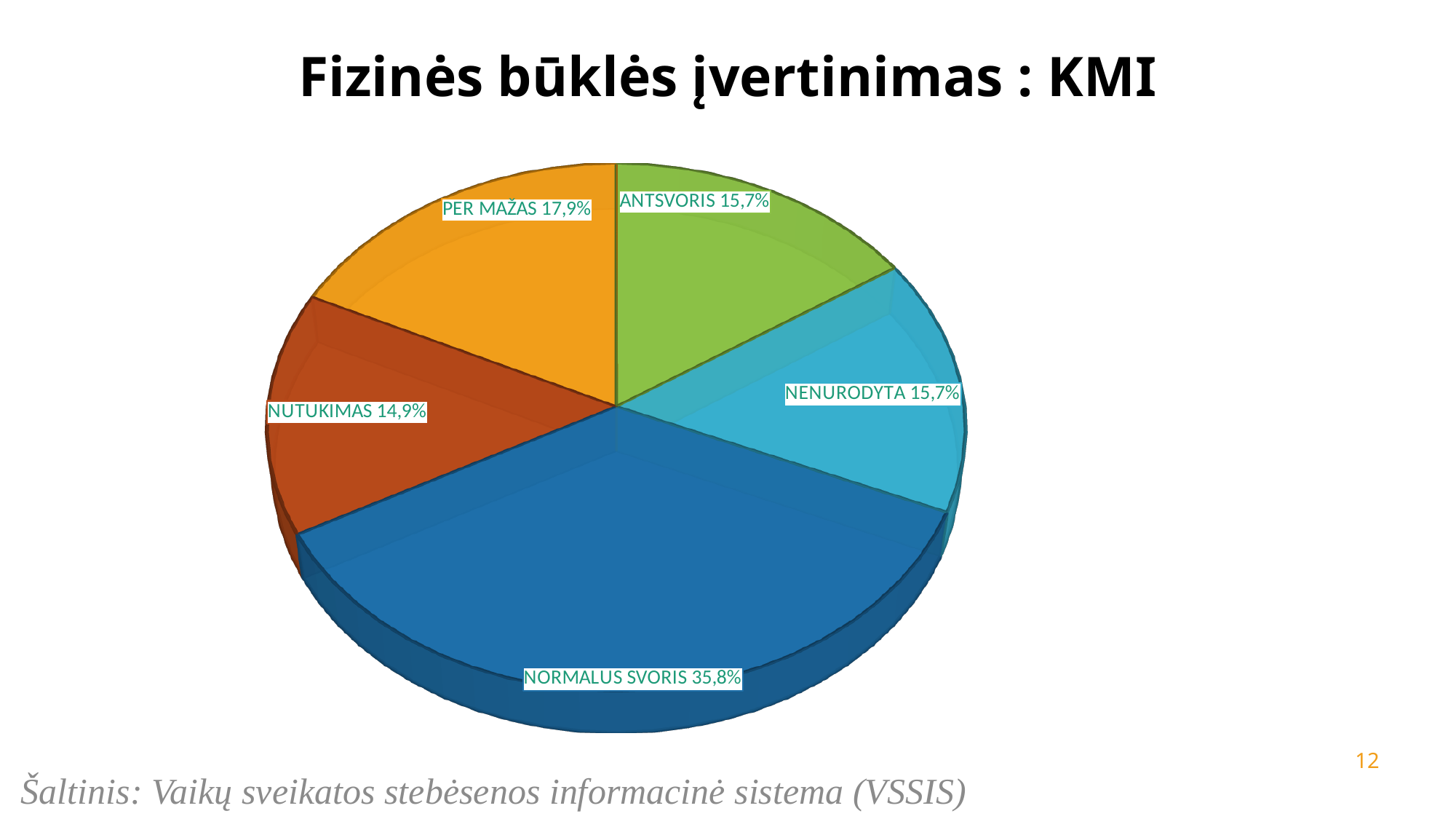
What is the value shown for ANTSVORIS? 15,7% What is the value shown for NUTUKIMAS? 14,9% Which category has the largest slice of the pie? NORMALUS SVORIS Which category has the smallest slice of the pie? NUTUKIMAS What kind of chart is shown on the slide? pie chart Which is larger, the share for PER MAŽAS or the share for NENURODYTA? PER MAŽAS What is the difference in percentage points between PER MAŽAS and NUTUKIMAS? 3,0 What share of the pie does NORMALUS SVORIS have? 35,8% How many slices does the pie chart have? 5 What is the value shown for PER MAŽAS? 17,9% What is the difference in percentage points between NORMALUS SVORIS and PER MAŽAS? 17,9 What is the title of the chart on the slide? Fizinės būklės įvertinimas : KMI